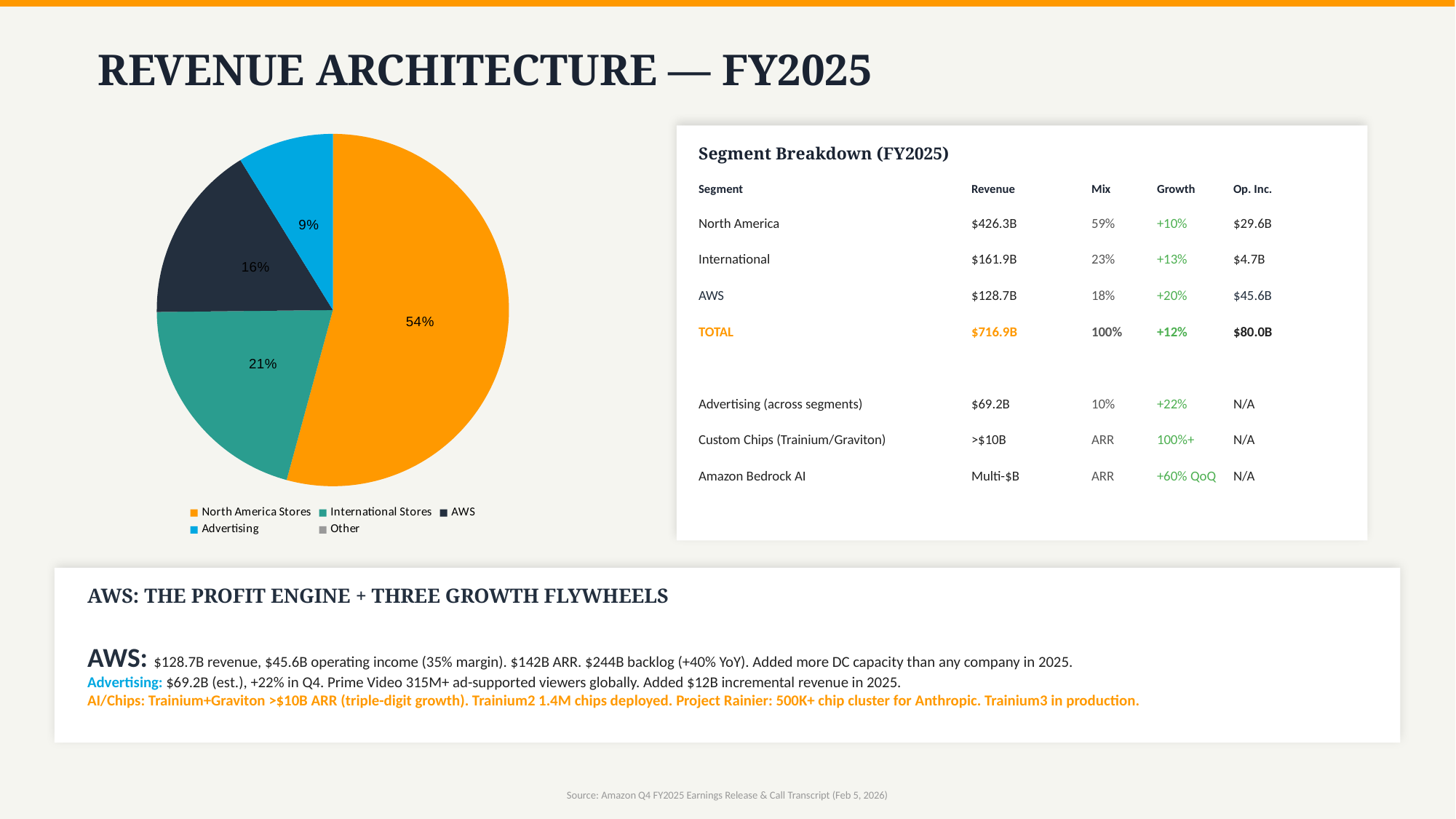
In the pie chart, what is the difference in percentage points between North America Stores and International Stores? 33 In the pie chart, what share is labelled for International Stores? 21% Which slice of the pie chart is the largest? North America Stores How many entries does the pie chart's legend list? 5 Which labelled slice of the pie chart is the smallest? Advertising How many slices of the pie chart have a percentage label? 4 In the pie chart, what share is labelled for Advertising? 9% What colour is the North America Stores slice in the pie chart? orange What kind of chart is shown on the left of the slide? pie chart In the pie chart, which is larger: the AWS slice or the Advertising slice? AWS In the pie chart, what share is labelled for AWS? 16% In the pie chart, what share is labelled for North America Stores? 54%